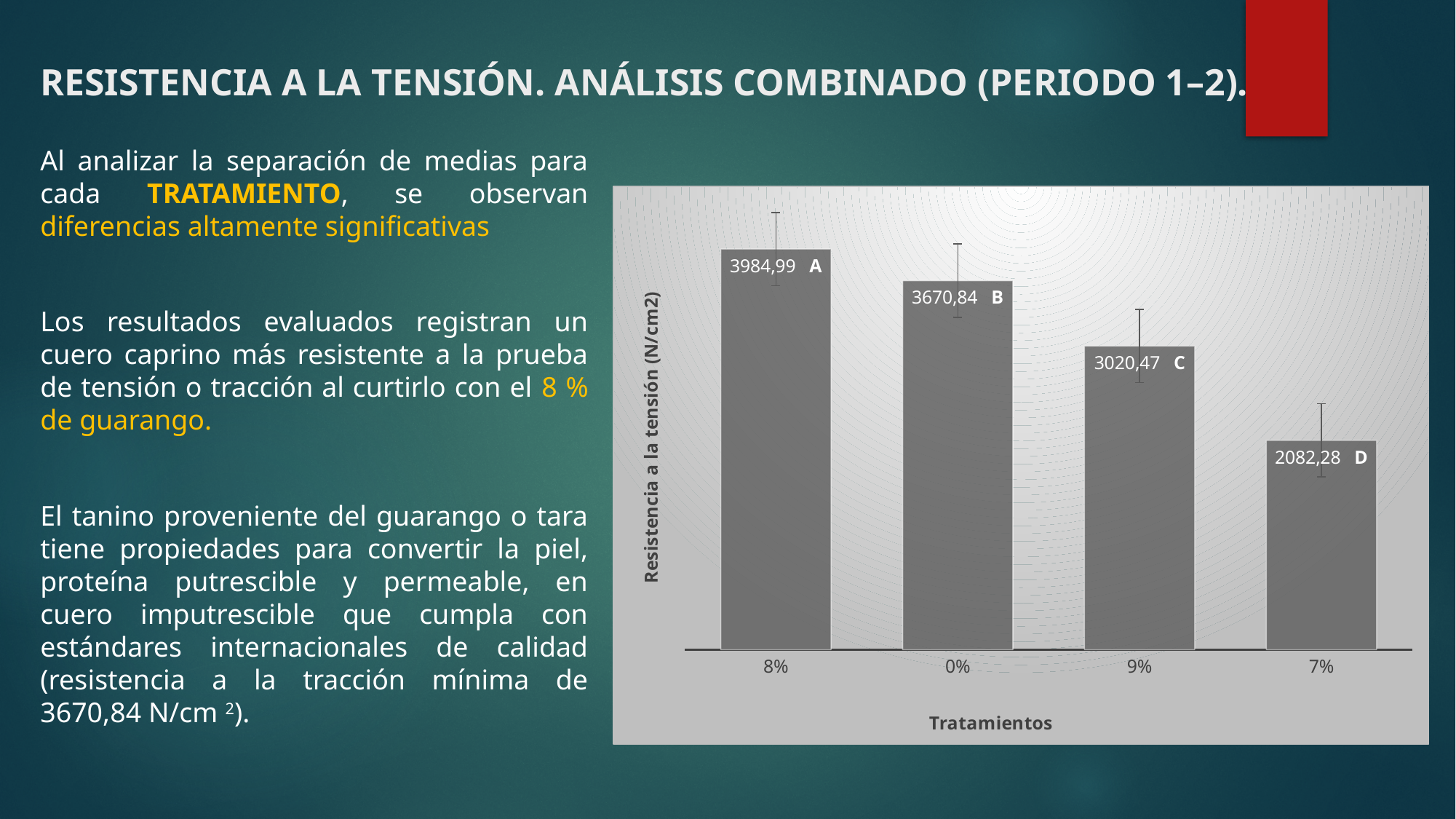
Which treatment has a larger tensile strength, 0% or 9%? 0% What is the tensile strength value for the 9% treatment? 3020,47 What kind of chart is shown on the slide? Bar chart What is the difference between the tensile strength of the 9% treatment and the 7% treatment? 938,19 What is the difference between the tensile strength of the 8% treatment and the 0% treatment? 314,15 What is the tensile strength value for the 8% treatment? 3984,99 What is the tensile strength value for the 7% treatment? 2082,28 How many treatments are shown on the x axis of the chart? 4 Which treatment has the highest tensile strength? 8% Which treatment has the lowest tensile strength? 7% What is the tensile strength value for the 0% treatment? 3670,84 Do the bar values rise or fall from left to right along the x axis? Fall